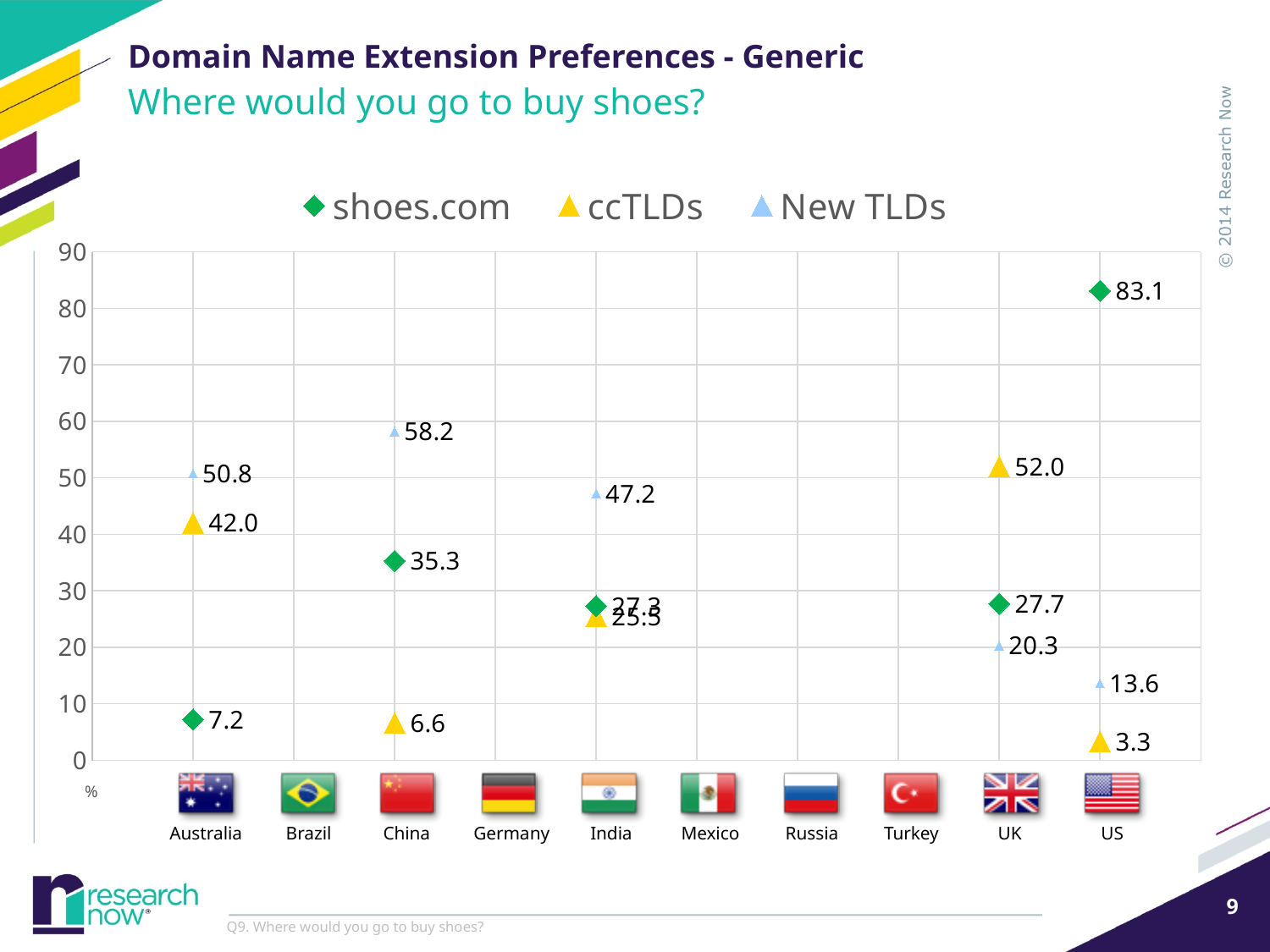
How many series does the legend list? 3 What is the shoes.com value for Australia? 7.2 Is the New TLDs value for India greater or less than 40? greater What is the New TLDs value for China? 58.2 For China, which is larger: the shoes.com value or the ccTLDs value? shoes.com Which country has the lowest ccTLDs value? US What is the shoes.com value for the US? 83.1 What is the difference between the New TLDs value and the ccTLDs value for Australia? 8.8 Which country has the highest shoes.com value? US What is the ccTLDs value for the UK? 52.0 How many countries are shown on the x axis? 10 What colour is the marker for the shoes.com series in the legend? Green